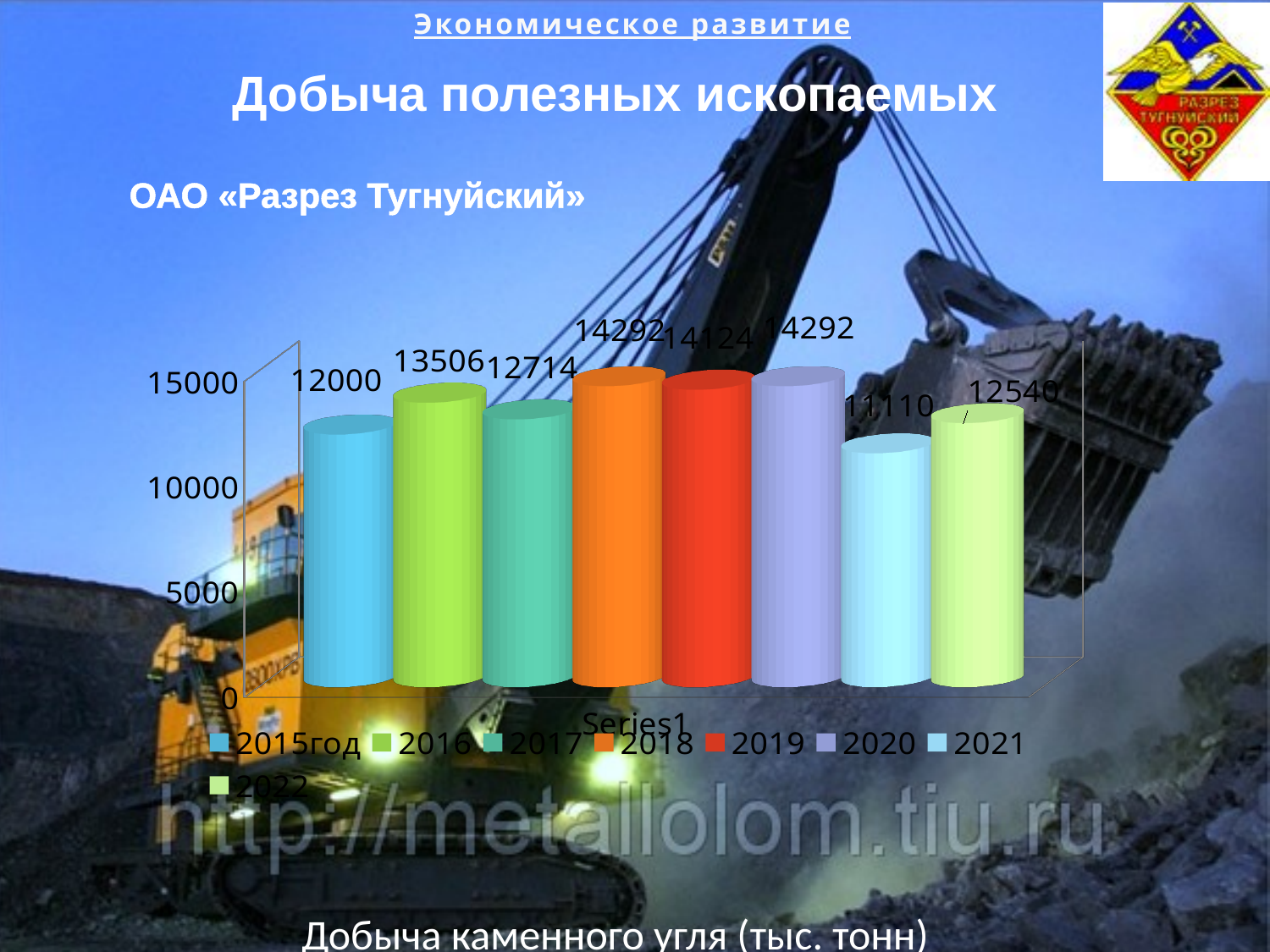
How many bars are plotted in the chart? 8 What is the value for 2022? 12540 Is the value for 2020 greater or less than 10000? greater What type of chart is shown on the slide? bar chart What is the value for 2019? 14124 What is the value for 2021? 11110 How many entries does the legend list? 8 Which is larger, the value for 2017 or the value for 2022? 2017 What is the difference between the values for 2018 and 2015год? 2292 Which year has the lowest value? 2021 What is the caption below the chart? Добыча каменного угля (тыс. тонн) What is the value for 2016? 13506